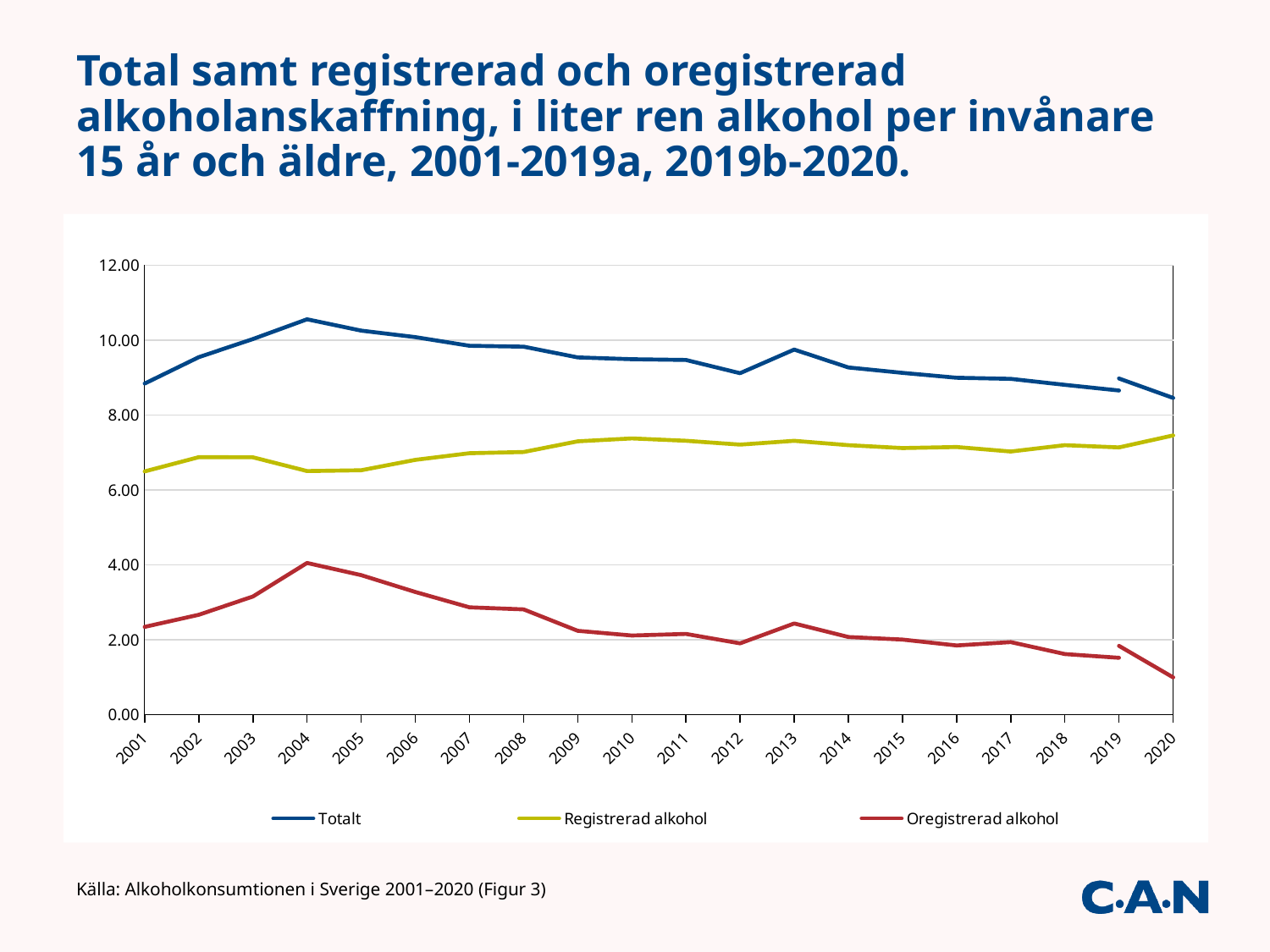
Does the Oregistrerad alkohol series rise or fall from 2004 to 2020? fall Is the value for Registrerad alkohol in 2001 greater or less than 6.00? greater Is the value for Totalt in 2004 greater or less than 10.00? greater In which year is the Totalt series at its lowest value? 2020 What kind of chart is shown on the slide? line chart Is the value for Oregistrerad alkohol in 2020 greater or less than 2.00? less In which year does the Totalt series reach its highest value? 2004 How many years are shown along the x axis? 20 How many series does the legend list? 3 Which series has the larger value in 2010, Registrerad alkohol or Oregistrerad alkohol? Registrerad alkohol In which year is the Oregistrerad alkohol series at its lowest value? 2020 In which year does the Oregistrerad alkohol series reach its highest value? 2004